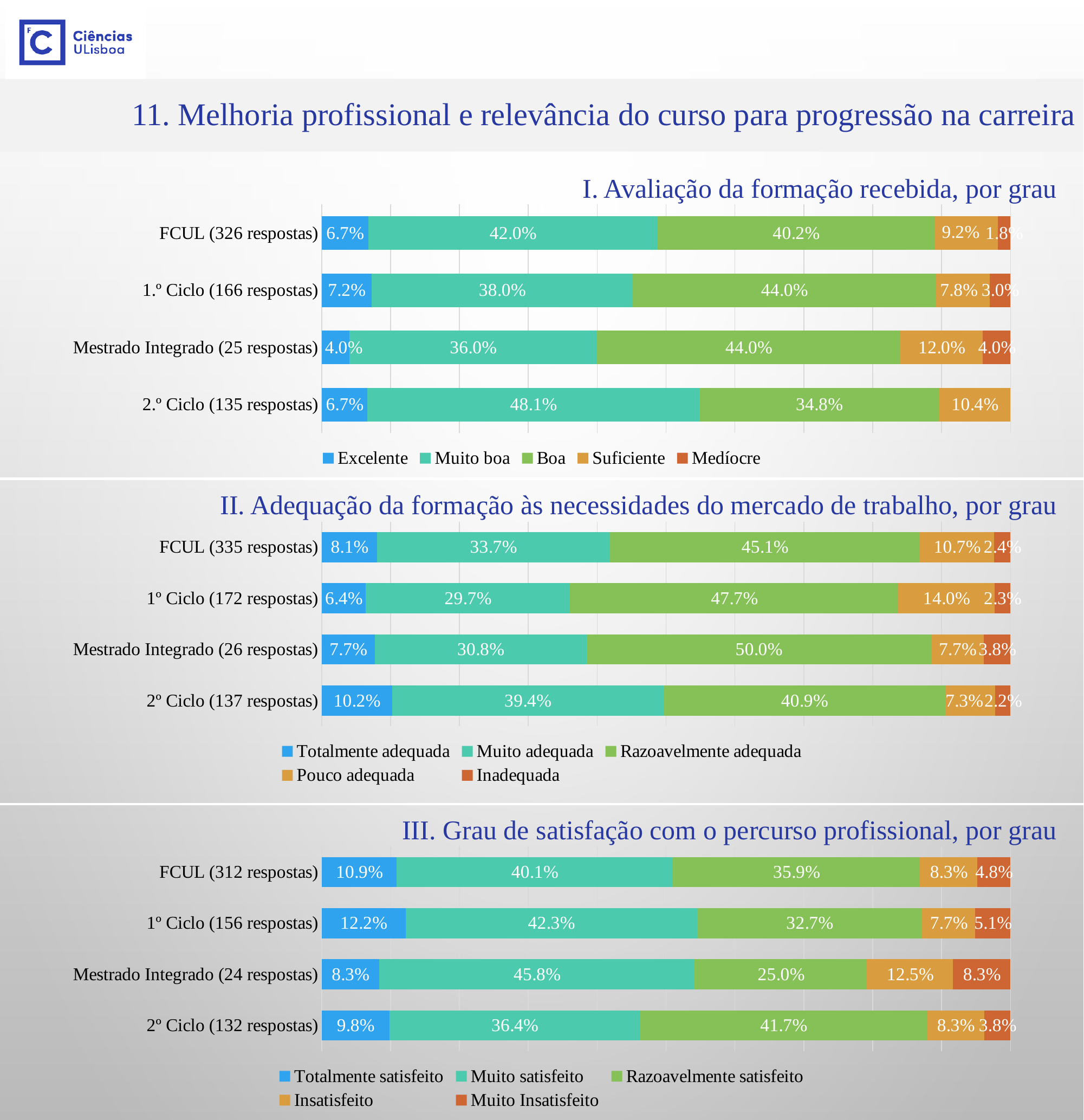
In chart II (Adequação da formação às necessidades do mercado de trabalho, por grau), what is the 'Razoavelmente adequada' value for Mestrado Integrado (26 respostas)? 50.0% In chart I (Avaliação da formação recebida, por grau), what is the 'Muito boa' value for 2.º Ciclo (135 respostas)? 48.1% In chart I (Avaliação da formação recebida, por grau), what is the difference between the 'Boa' values for 1.º Ciclo and FCUL? 3.8% In chart III (Grau de satisfação com o percurso profissional, por grau), what is the difference between the 'Totalmente satisfeito' values for 1º Ciclo and 2º Ciclo? 2.4% In chart III (Grau de satisfação com o percurso profissional, por grau), what is the 'Muito satisfeito' value for Mestrado Integrado (24 respostas)? 45.8% In chart I (Avaliação da formação recebida, por grau), how many series does the legend list? 5 In chart III (Grau de satisfação com o percurso profissional, por grau), which category has the lowest 'Razoavelmente satisfeito' value? Mestrado Integrado (24 respostas) In chart I (Avaliação da formação recebida, por grau), which category has the highest 'Suficiente' value? Mestrado Integrado (25 respostas) In chart II (Adequação da formação às necessidades do mercado de trabalho, por grau), how many categories are shown on the vertical axis? 4 In chart II (Adequação da formação às necessidades do mercado de trabalho, por grau), which is larger: the 'Pouco adequada' value for 1º Ciclo or for FCUL? 1º Ciclo What type of chart is chart III (Grau de satisfação com o percurso profissional, por grau)? Stacked bar chart In chart II (Adequação da formação às necessidades do mercado de trabalho, por grau), which category has the highest 'Totalmente adequada' value? 2º Ciclo (137 respostas)